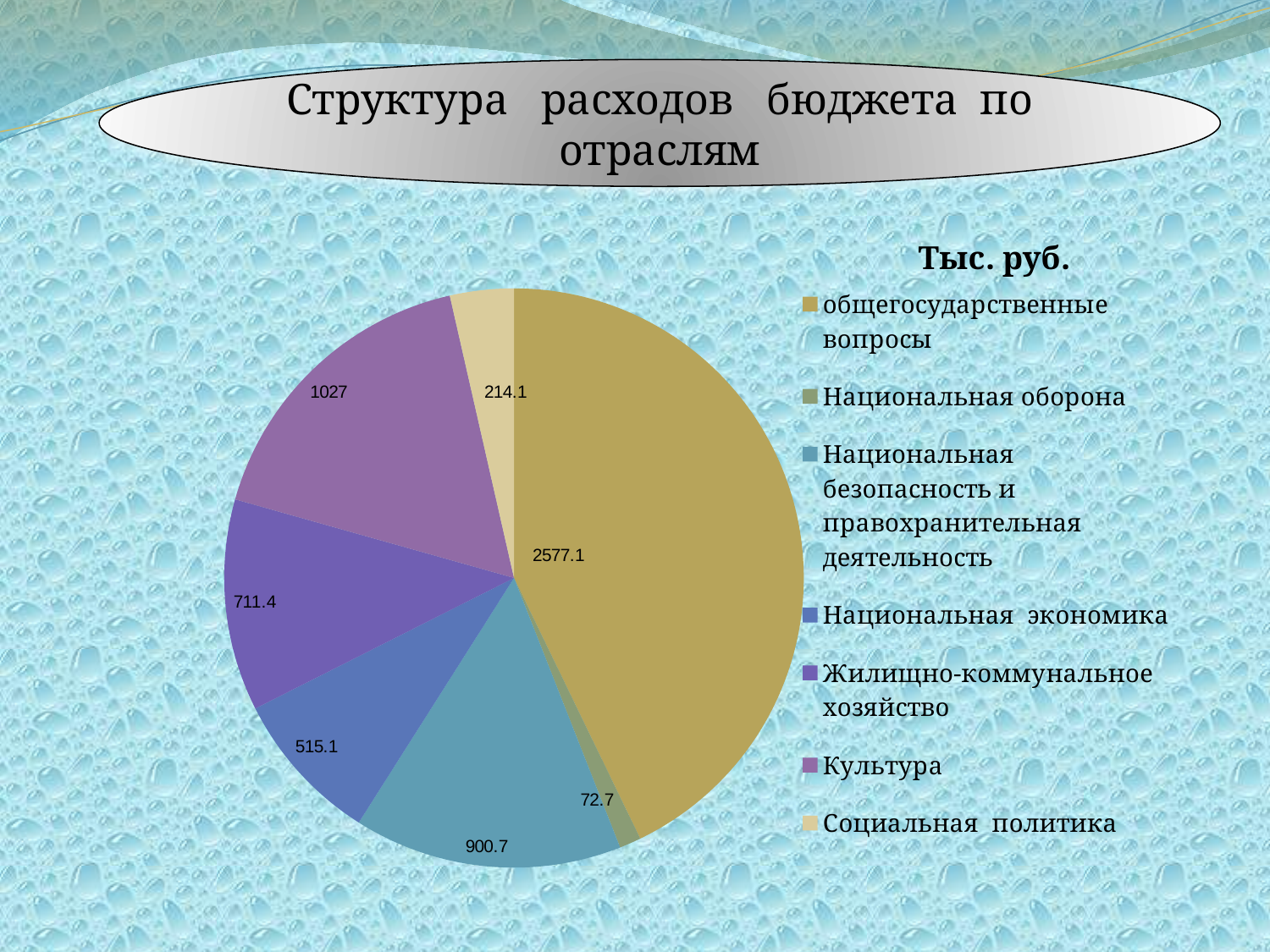
What is the value for Культура? 1027 Which category has the largest slice of the pie? общегосударственные вопросы What is the difference between the values for общегосударственные вопросы and Культура? 1550.1 What kind of chart is shown on the slide? Pie chart Which is larger: Национальная безопасность и правохранительная деятельность or Национальная экономика? Национальная безопасность и правохранительная деятельность Which category has the smallest slice of the pie? Национальная оборона What is the title of the chart on the slide? Тыс. руб. What is the value for общегосударственные вопросы? 2577.1 What is the difference between the values for Социальная политика and Национальная оборона? 141.4 What is the value for Жилищно-коммунальное хозяйство? 711.4 How many categories does the pie chart have? 7 What is the value for Национальная оборона? 72.7